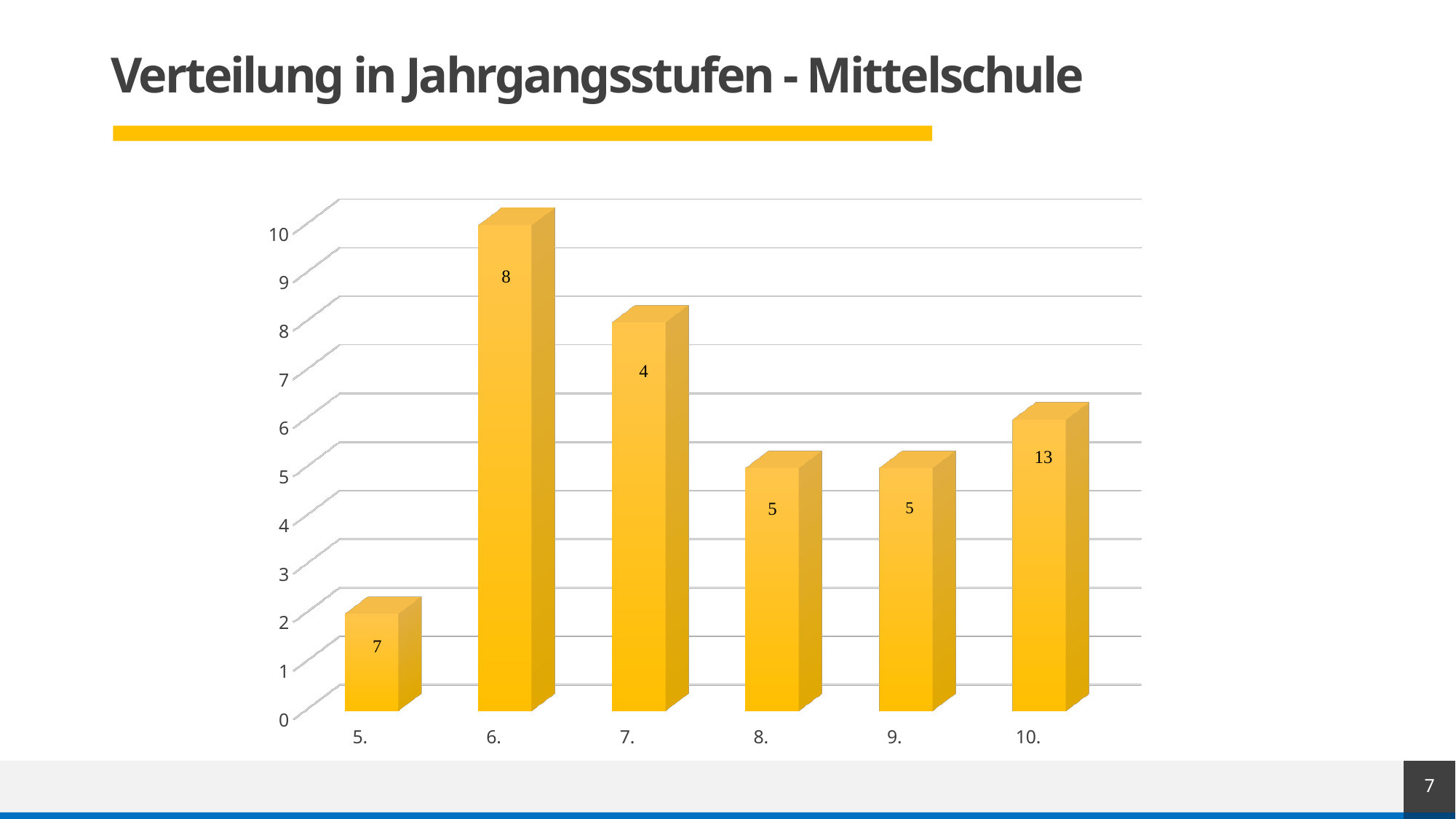
Is the value for 5. greater or less than 10? less Is the value for 8. greater or less than 10? less Which is larger, the value for 5. or the value for 6.? 6. What is the title of the slide containing the chart? Verteilung in Jahrgangsstufen - Mittelschule How many categories (Jahrgangsstufen) are shown on the x axis? 6 Is the value for 6. greater or less than 5? greater What kind of chart is shown on the slide? bar chart Which is larger, the value for 6. or the value for 8.? 6. Which is larger, the value for 6. or the value for 7.? 6. What is the highest tick value shown on the y axis? 10